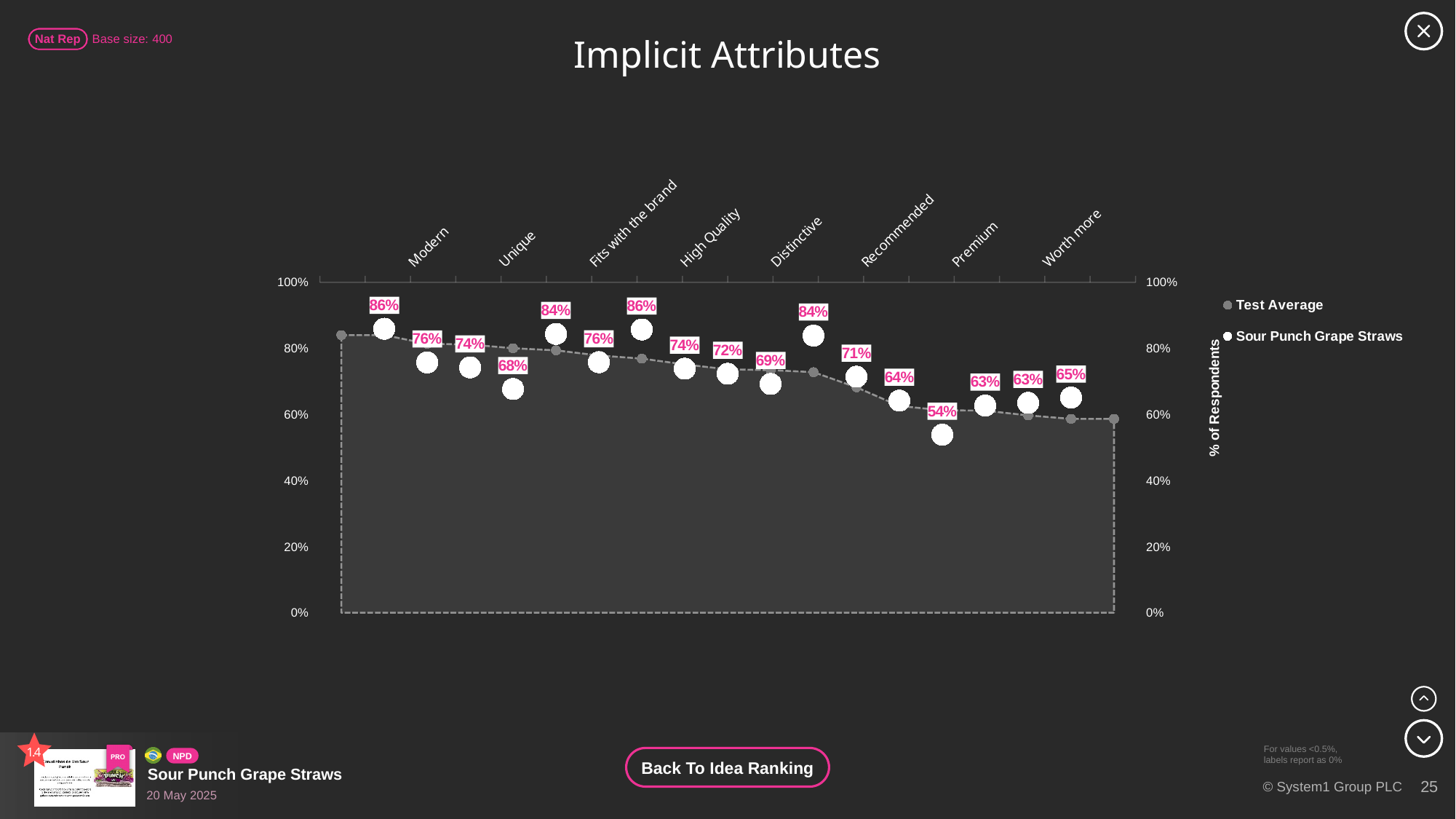
What is the lowest labelled value for Sour Punch Grape Straws? 54% What is the title of the chart? Implicit Attributes Do the Test Average values generally rise or fall from left to right across the chart? Fall What kind of chart is shown on the slide? Combination area and line chart How many series does the legend list? 2 What are the two series named in the legend? Test Average and Sour Punch Grape Straws How many times does the value 86% appear as a data label on the chart? 2 How many Sour Punch Grape Straws data points are plotted on the chart? 17 What is the highest labelled value for Sour Punch Grape Straws? 86% What is the difference between the highest and lowest labelled Sour Punch Grape Straws values? 32 percentage points Is the lowest Sour Punch Grape Straws value greater or less than 60%? less What is the label on the vertical axis of the chart? % of Respondents